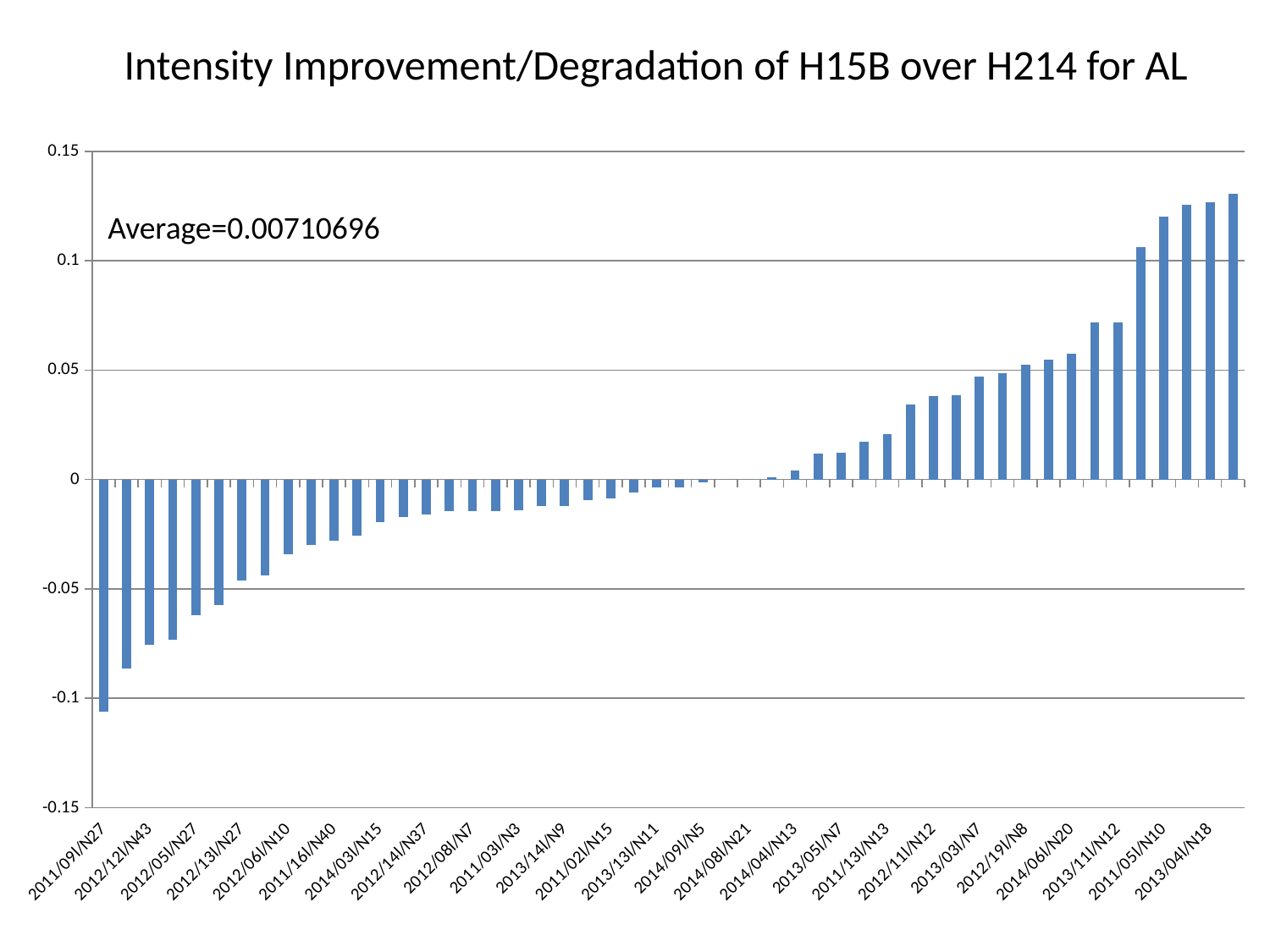
Which category has the lowest value? 2011/09l/N27 What kind of chart is shown on the slide? bar chart Is the value for 2012/12/N43 greater or less than -0.05? less What average value is printed on the chart? Average=0.00710696 What is the title of the chart? Intensity Improvement/Degradation of H15B over H214 for AL Is the value for 2011/09/N27 greater or less than -0.1? less Is the value for 2013/11/N12 greater or less than 0.05? greater Do the bar values rise or fall from left to right along the x axis? rise Which has the larger value, 2013/11/N12 or 2011/05/N10? 2011/05l/N10